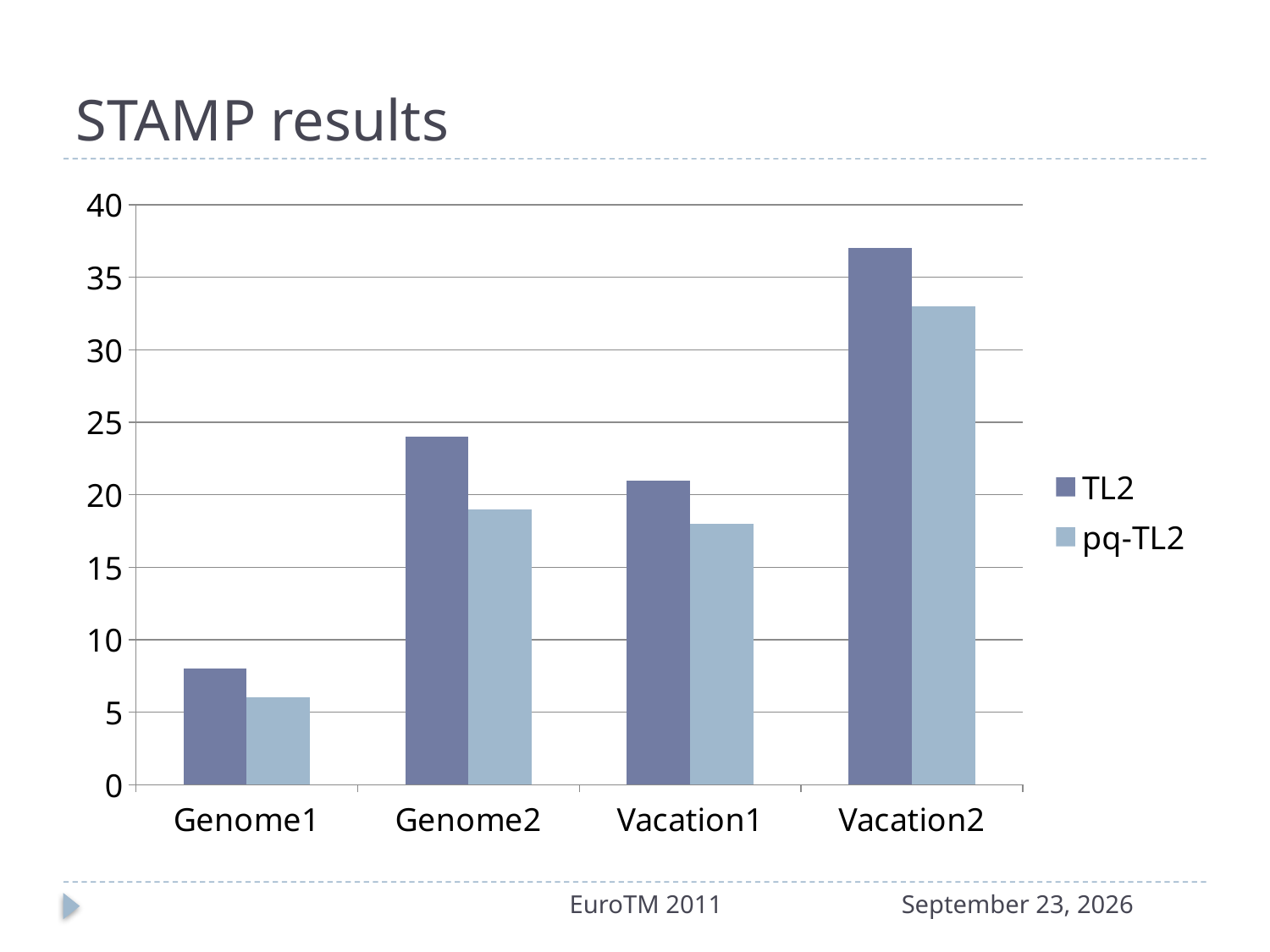
Is the pq-TL2 value for Genome1 greater or less than 10? less Is the pq-TL2 value for Vacation1 greater or less than 20? less For Genome2, which series has the larger value, TL2 or pq-TL2? TL2 Which is larger: the TL2 value for Vacation1 or the TL2 value for Genome2? Genome2 Which category has the highest TL2 value? Vacation2 Which category has the lowest pq-TL2 value? Genome1 How many series does the legend list? 2 What kind of chart is shown on the slide? bar chart Is the TL2 value for Vacation2 greater or less than 35? greater What is the title of the slide containing the chart? STAMP results How many categories are shown on the x axis? 4